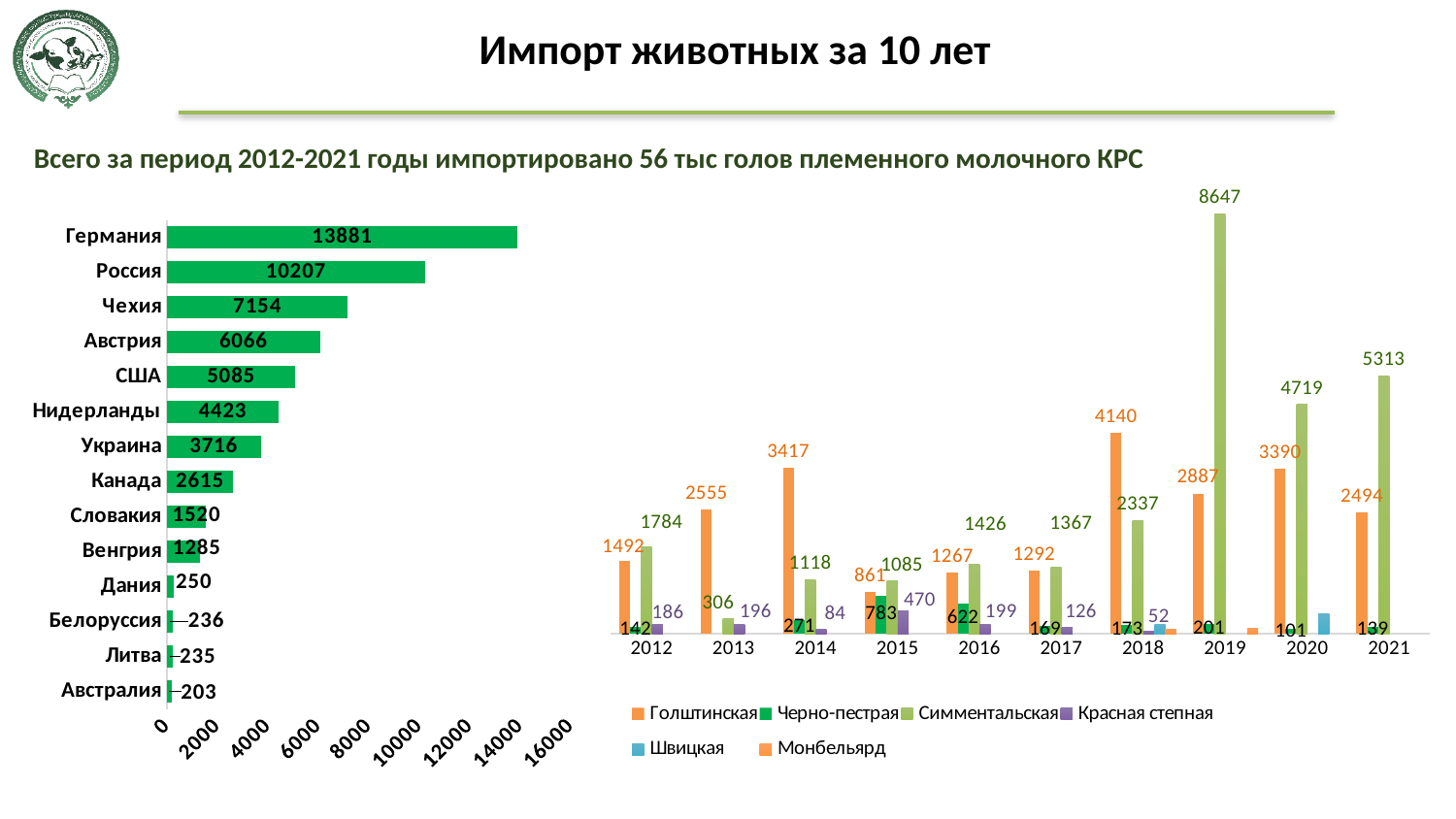
In the left chart, which country has the lowest value? Австралия In the right chart, how many series does the legend list? 6 In the left chart, how many countries are shown? 14 In the left chart, what is the value for Германия? 13881 In the left chart, which is larger, the value for США or the value for Нидерланды? США In the right chart, what is the difference between the Симментальская values for 2021 and 2020? 594 In the left chart, what is the difference between the values for Россия and Чехия? 3053 In the right chart, what is the value for Голштинская in 2018? 4140 What kind of chart is the left chart? bar chart In the right chart, what is the value for Симментальская in 2019? 8647 In the right chart, how many years are shown on the x axis? 10 In the right chart, in which year is the Голштинская value the lowest? 2015